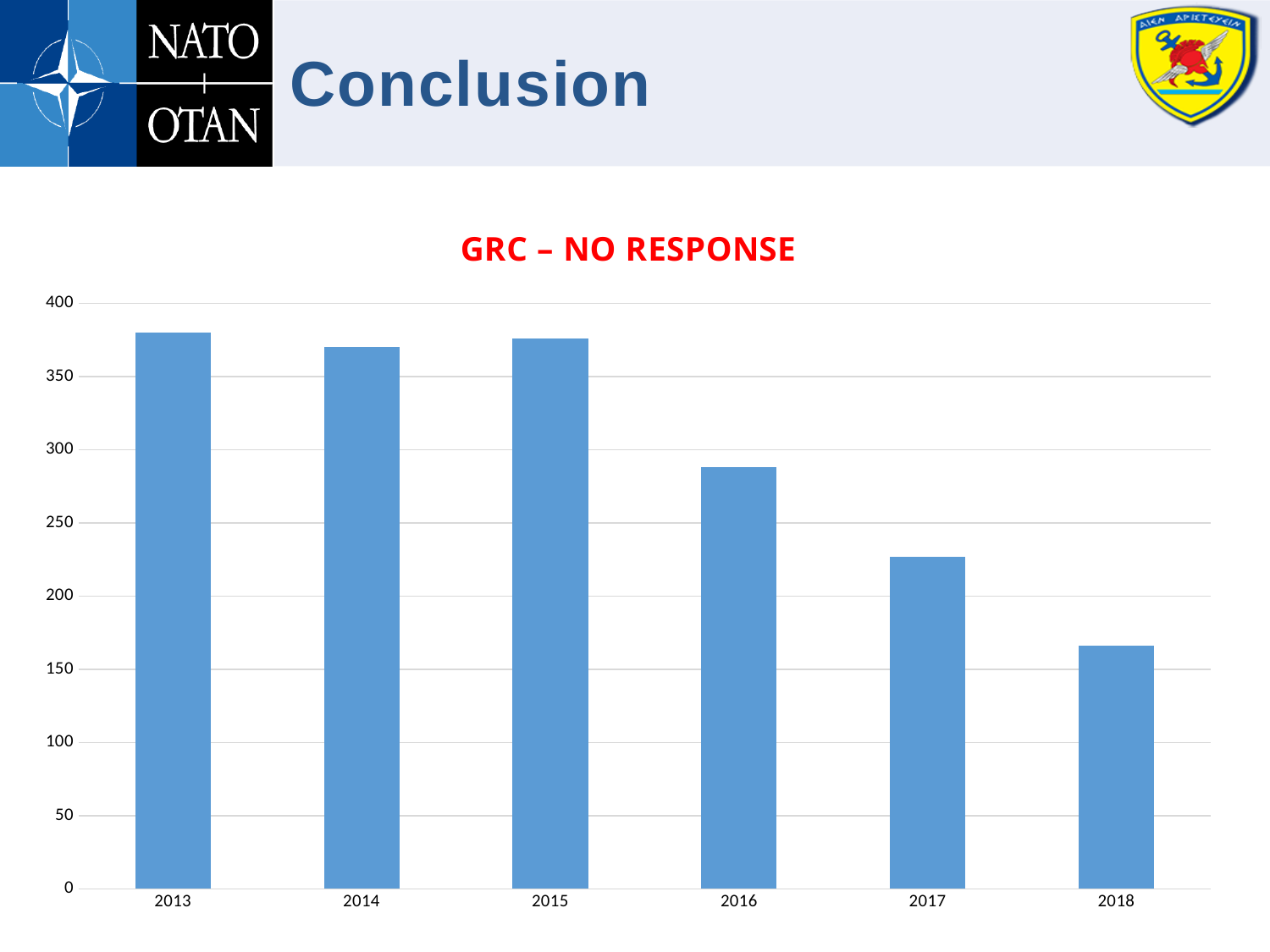
What kind of chart is shown on the slide? bar chart Is the value for 2017 greater or less than 200? greater Which is larger, the value for 2016 or the value for 2018? 2016 How many years are shown on the x axis of the chart? 6 Is the value for 2018 greater or less than 200? less Is the value for 2013 greater or less than 350? greater Which year has the lowest value in the chart? 2018 What is the title of the chart? GRC – NO RESPONSE Do the values generally rise or fall from 2013 to 2018? fall Which is larger, the value for 2014 or the value for 2017? 2014